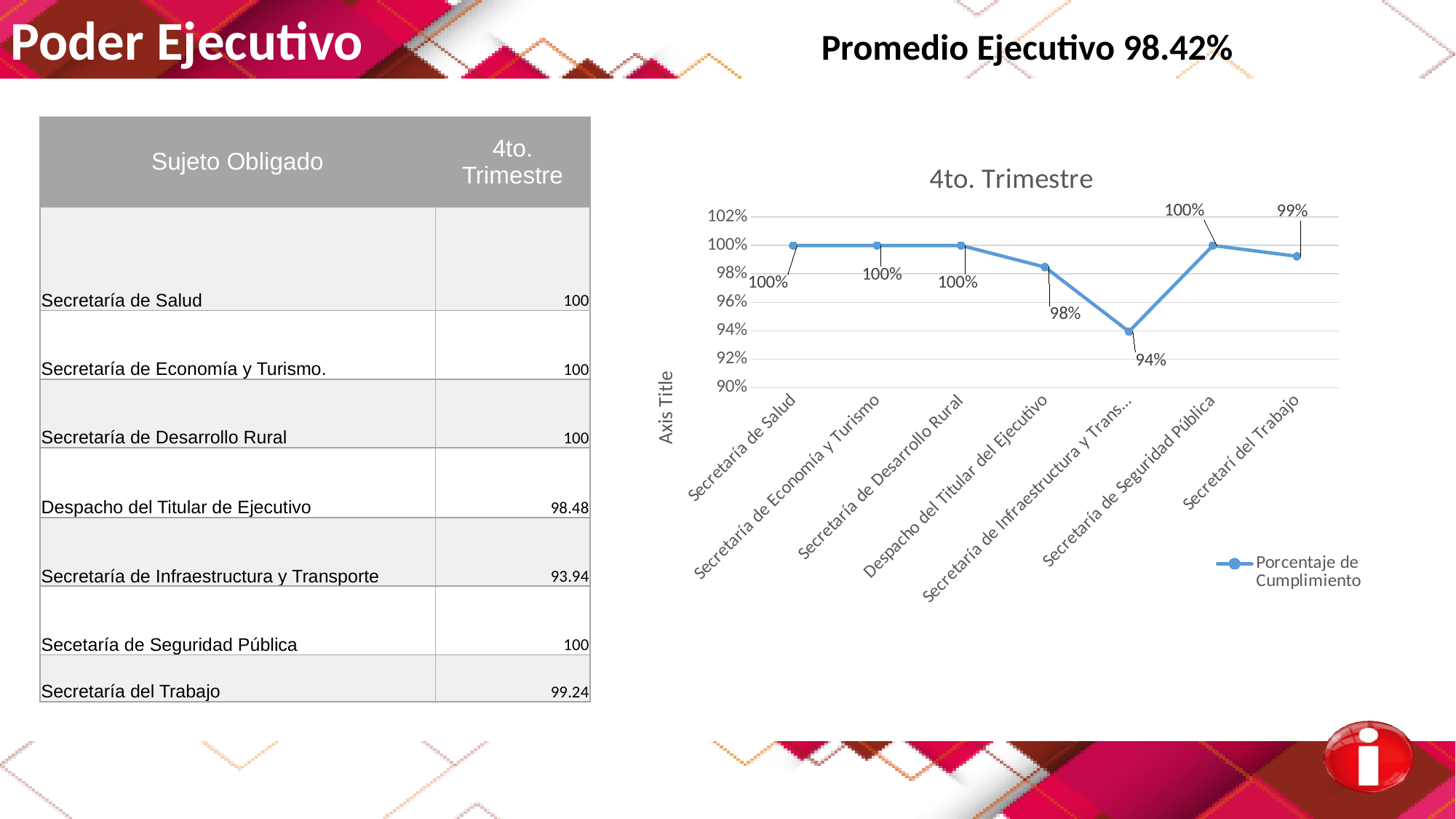
Which category has the lowest value in the chart? Secretaría de Infraestructura y Trans... Which is larger: the value for Despacho del Titular del Ejecutivo or the value for Secretaría de Infraestructura y Trans...? Despacho del Titular del Ejecutivo How many categories are plotted on the x axis of the chart? 7 What type of chart is shown on the slide? line chart What is the difference between the value for Secretaría de Seguridad Pública and the value for Secretaría de Infraestructura y Trans...? 6% What is the value for Secretarí del Trabajo in the chart? 99% How many series does the chart legend list? 1 What is the title of the chart? 4to. Trimestre What is the value for Secretaría de Infraestructura y Trans... in the chart? 94% What is the name of the series shown in the chart legend? Porcentaje de Cumplimiento What is the value for Secretaría de Salud in the chart? 100% What is the value for Despacho del Titular del Ejecutivo in the chart? 98%